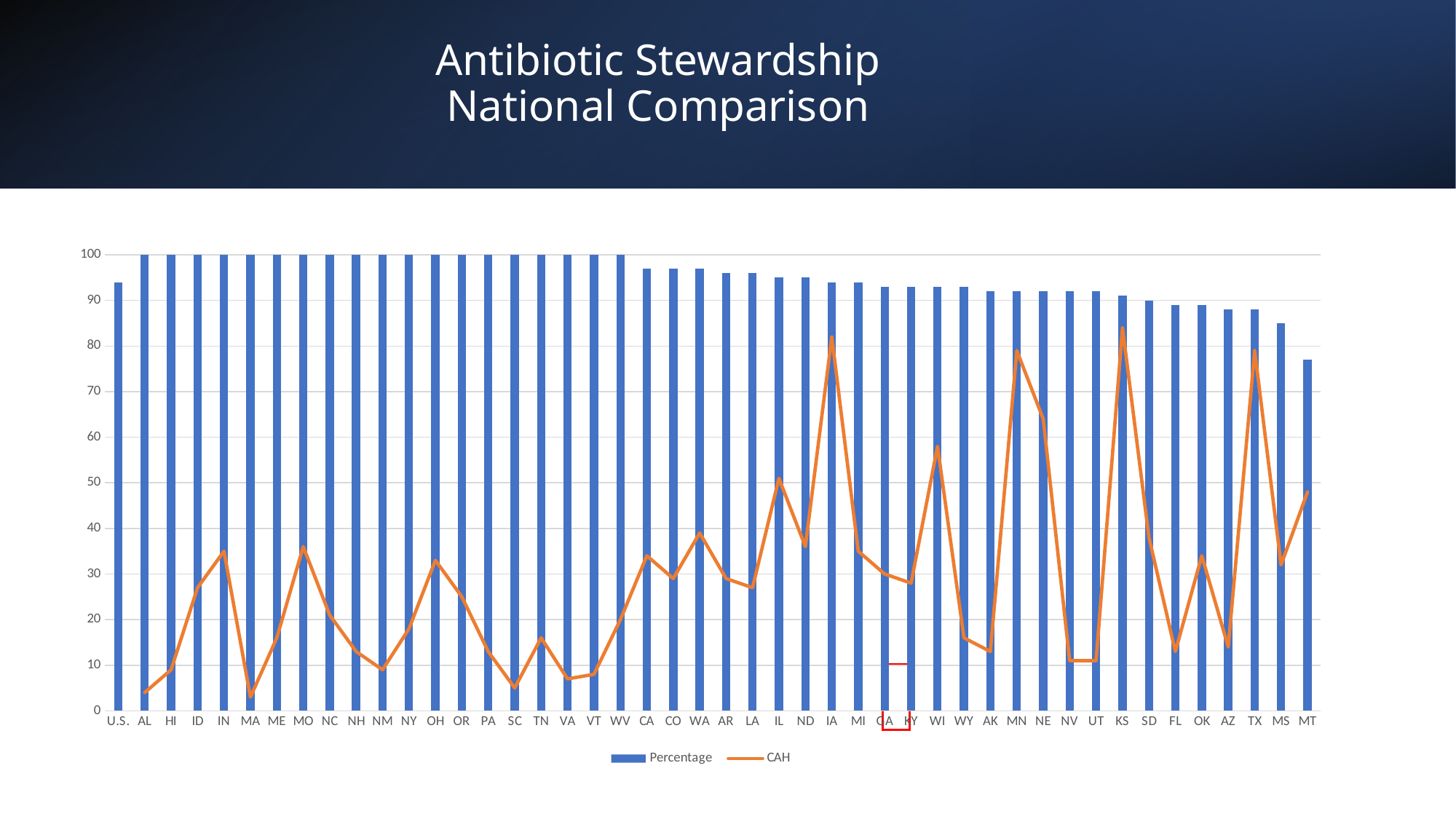
What colour is the CAH series in the legend? orange Is the CAH value for IA greater or less than 80? greater What kind of chart is shown on the slide? bar chart with a line Is the CAH value for MA greater or less than 10? less Is the Percentage value for MT greater or less than 80? less Which has the larger CAH value, MN or NE? MN How many series does the legend list? 2 What is the Percentage value for WV? 100 Which has the larger Percentage value, MS or MT? MS Which category has the lowest Percentage bar? MT Do the Percentage bars rise or fall from left to right along the x axis? fall What is the Percentage value for AL? 100